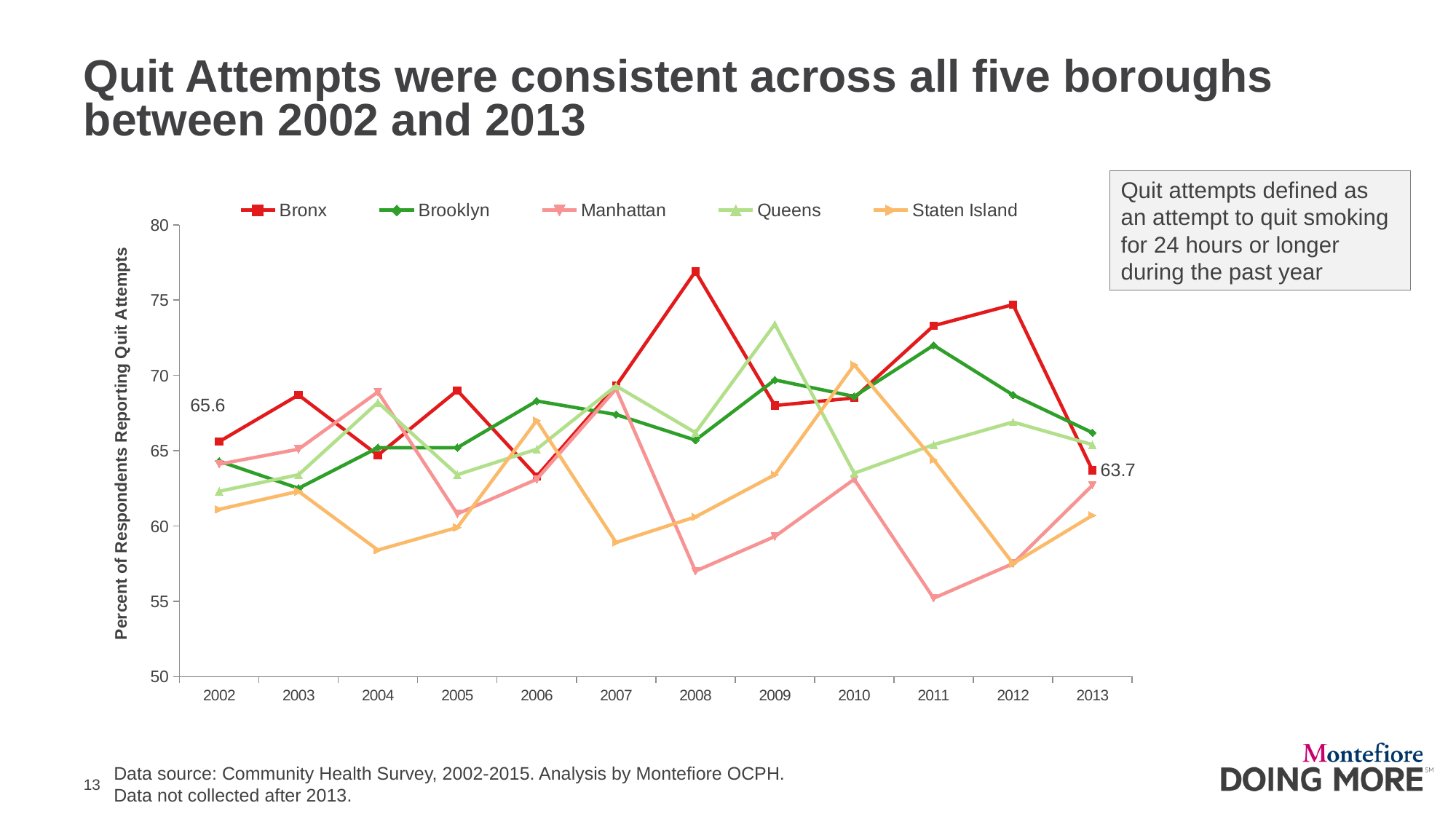
Is the value for Manhattan in 2011 greater or less than 60? less How many years are plotted along the x axis? 12 How many series does the legend list? 5 What was the percent of respondents reporting quit attempts in the Bronx in 2002? 65.6 What was the percent of respondents reporting quit attempts in the Bronx in 2013? 63.7 In 2009, which had the larger value, Queens or Manhattan? Queens By how much did the Bronx value fall from 2002 to 2013? 1.9 What kind of chart is shown on the slide? line chart Is the value for the Bronx in 2008 greater or less than 75? greater Which borough had the lowest percent of respondents reporting quit attempts in 2011? Manhattan Which borough had the highest percent of respondents reporting quit attempts in 2008? Bronx What is the title of the y axis? Percent of Respondents Reporting Quit Attempts